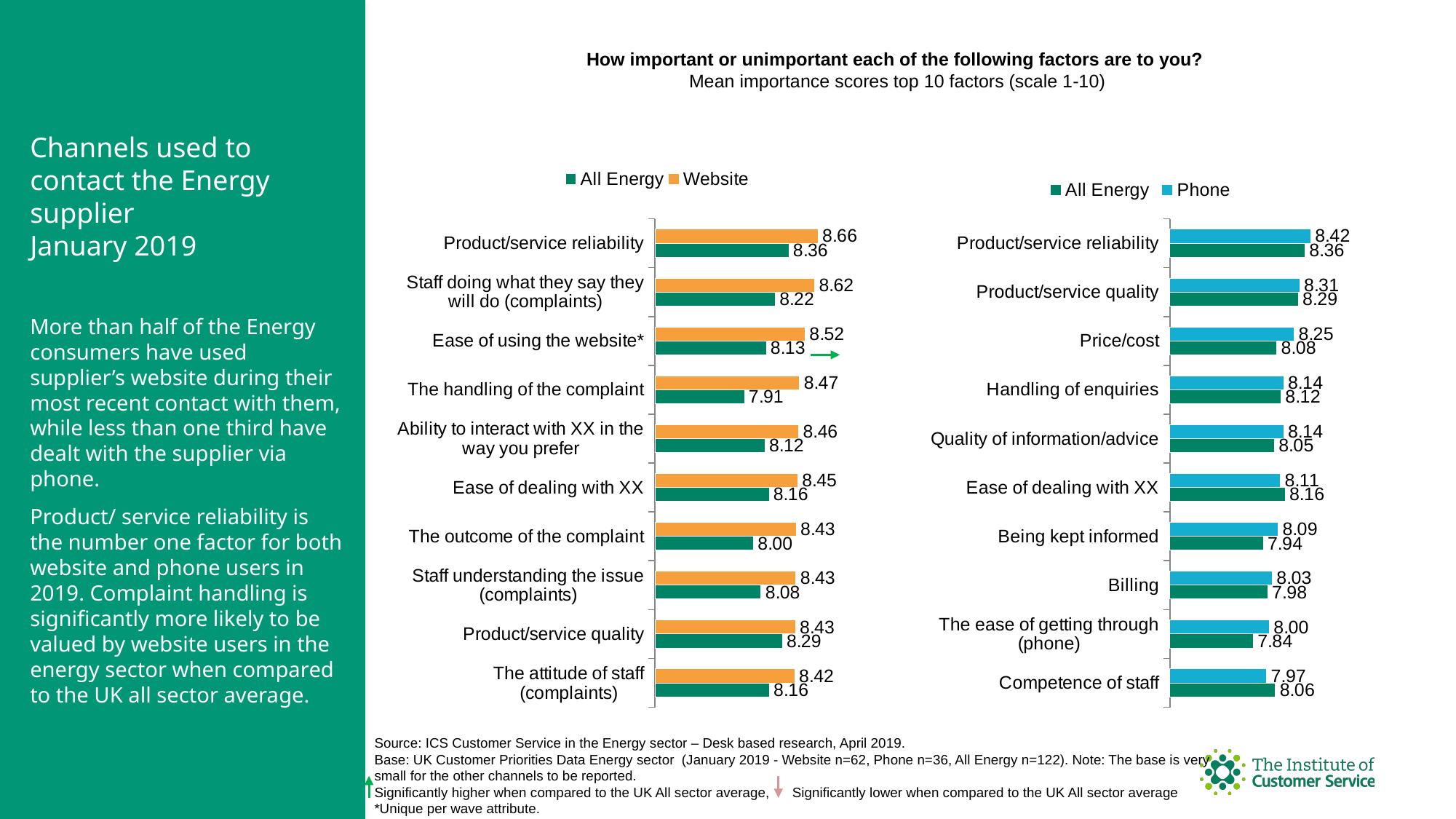
In the left chart (All Energy vs Website), how many factors are listed? 10 In the right chart (All Energy vs Phone), which factor has the highest Phone score? Product/service reliability In the right chart (All Energy vs Phone), what is the Phone score for Price/cost? 8.25 In the right chart (All Energy vs Phone), what is the difference between the Phone and All Energy scores for The ease of getting through (phone)? 0.16 In the right chart (All Energy vs Phone), which factor has the lowest Phone score? Competence of staff In the left chart (All Energy vs Website), what colour are the Website bars? Orange In the right chart (All Energy vs Phone), which is larger for Ease of dealing with XX: the Phone score or the All Energy score? All Energy In the left chart (All Energy vs Website), what is the All Energy score for The handling of the complaint? 7.91 In the left chart (All Energy vs Website), what is the Website score for Product/service reliability? 8.66 What type of chart is the left chart (All Energy vs Website)? Bar chart In the left chart (All Energy vs Website), what is the difference between the Website and All Energy scores for The handling of the complaint? 0.56 In the right chart (All Energy vs Phone), how many series does the legend list? 2